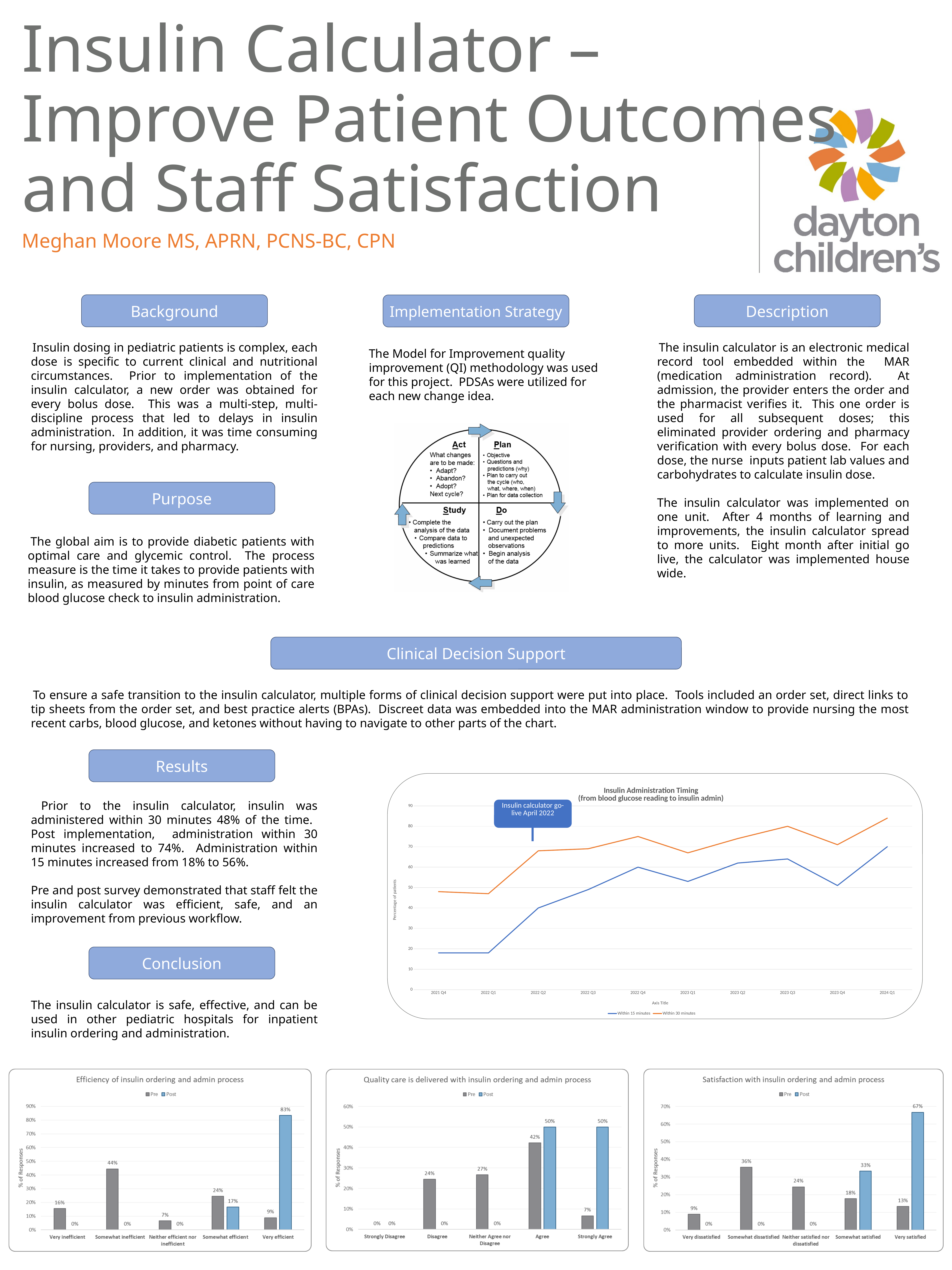
How many quarters are plotted on the x axis of the 'Insulin Administration Timing' chart? 10 In the 'Satisfaction with insulin ordering and admin process' chart, which category has the lowest Pre value? Very dissatisfied In the 'Satisfaction with insulin ordering and admin process' chart, what is the Post value for Very satisfied? 67% In the 'Quality care is delivered with insulin ordering and admin process' chart, which is larger for Strongly Agree, the Pre value or the Post value? Post In the 'Quality care is delivered with insulin ordering and admin process' chart, what is the Pre value for Agree? 42% In the 'Efficiency of insulin ordering and admin process' chart, what is the Post value for Very efficient? 83% What kind of chart is the 'Insulin Administration Timing' chart? line chart In the 'Efficiency of insulin ordering and admin process' chart, what is the difference between the Pre and Post values for Somewhat efficient? 7% In the 'Efficiency of insulin ordering and admin process' chart, which category has the highest Pre value? Somewhat inefficient In the 'Satisfaction with insulin ordering and admin process' chart, what is the difference between the Post and Pre values for Somewhat satisfied? 15% In the 'Insulin Administration Timing' chart, is the 'Within 30 minutes' value for 2024 Q1 greater or less than 80? greater How many series does the legend of the 'Insulin Administration Timing' chart list? 2